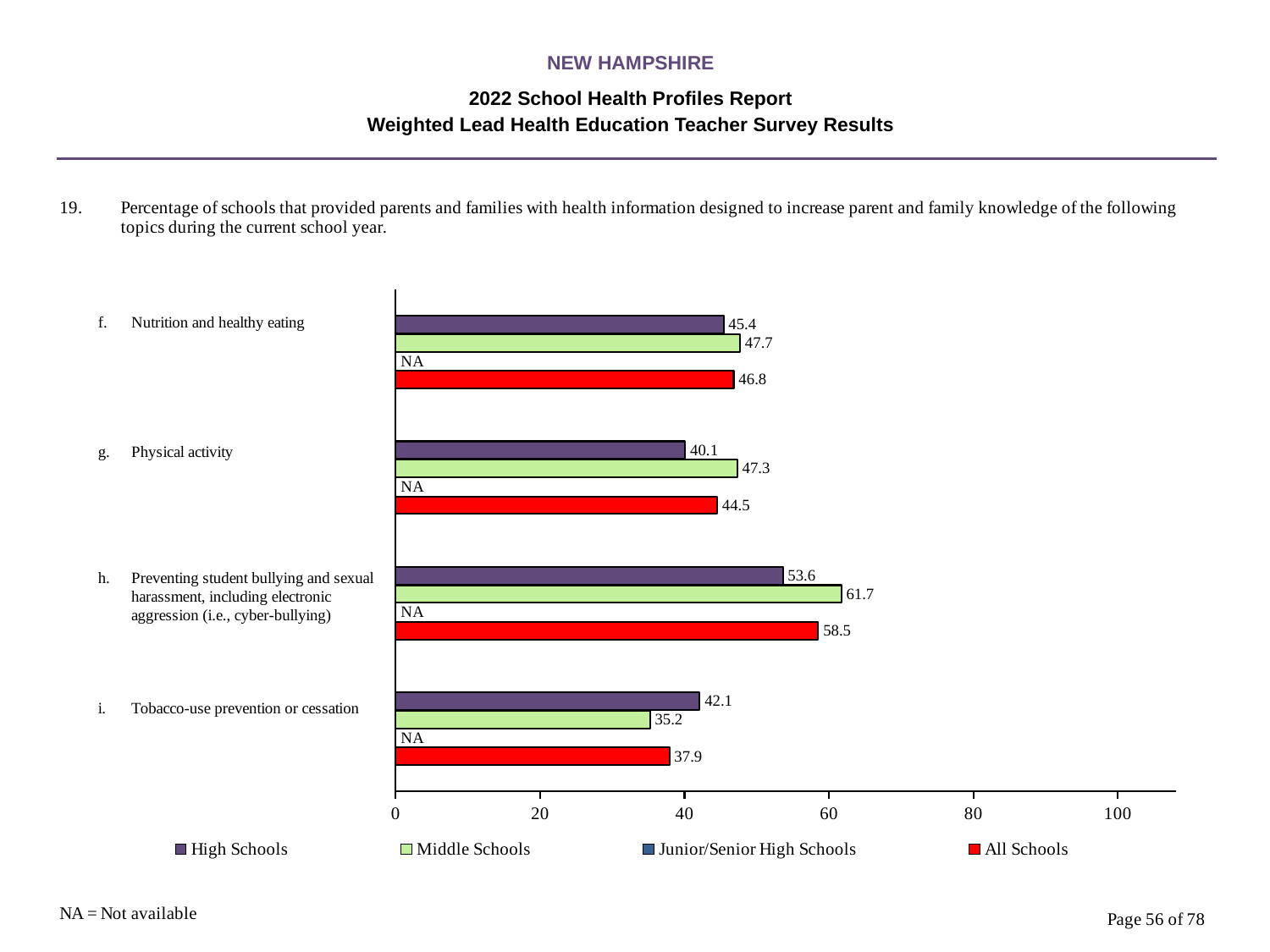
What is the value for Middle Schools for Preventing student bullying and sexual harassment, including electronic aggression? 61.7 What is the value for High Schools for Nutrition and healthy eating? 45.4 Which topic has the lowest value for Middle Schools? Tobacco-use prevention or cessation What is the difference between the Middle Schools and High Schools values for Physical activity? 7.2 How many series does the legend list? 4 For Tobacco-use prevention or cessation, which is larger: the High Schools value or the Middle Schools value? High Schools What is shown for Junior/Senior High Schools for Physical activity? NA How many topics are shown on the chart? 4 Which topic has the highest value for All Schools? Preventing student bullying and sexual harassment, including electronic aggression (i.e., cyber-bullying) Is the All Schools value for Preventing student bullying and sexual harassment greater or less than 40? greater What kind of chart is shown on the slide? bar chart What is the value for All Schools for Tobacco-use prevention or cessation? 37.9